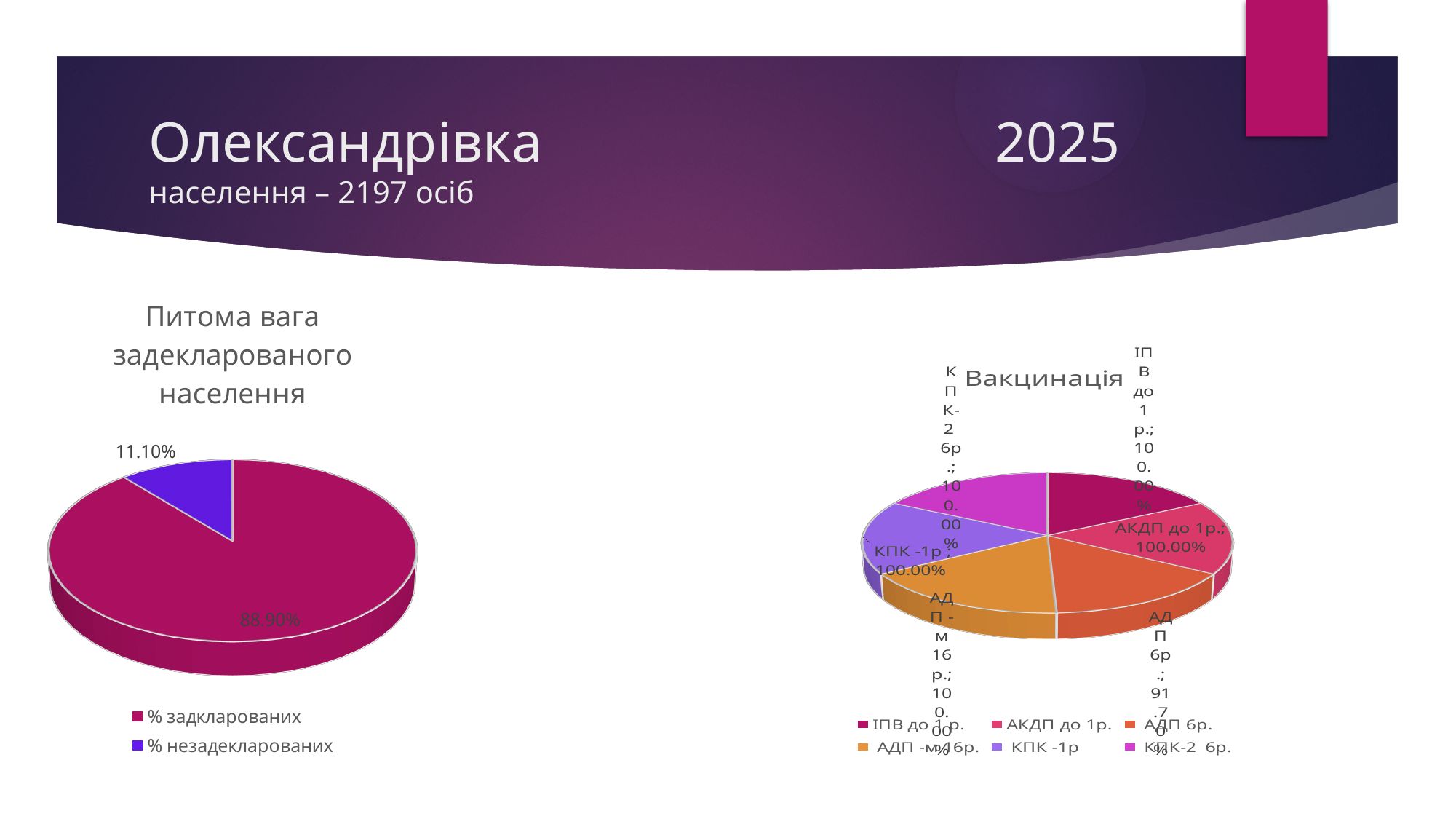
How many slices does the left chart "Питома вага задекларованого населення" have? 2 In the right chart "Вакцинація", what is the value for "АКДП до 1р."? 100.00% In the left chart "Питома вага задекларованого населення", what is the value for "% задклярованих"? 88.90% What kind of chart is the left chart titled "Питома вага задекларованого населення"? pie chart In the left chart "Питома вага задекларованого населення", what is the value for "% незадекларованих"? 11.10% In the right chart "Вакцинація", which category has the lowest value? АДП 6р. How many entries does the legend of the right chart "Вакцинація" list? 6 What kind of chart is the right chart titled "Вакцинація"? pie chart In the left chart "Питома вага задекларованого населення", what is the difference between the two slices? 77.80% In the left chart "Питома вага задекларованого населення", which category has the largest slice? % задкларованих In the right chart "Вакцинація", what is the value for "АДП 6р."? 91.70% In the right chart "Вакцинація", which is larger: the value for "КПК -1р" or the value for "АДП 6р."? КПК -1р